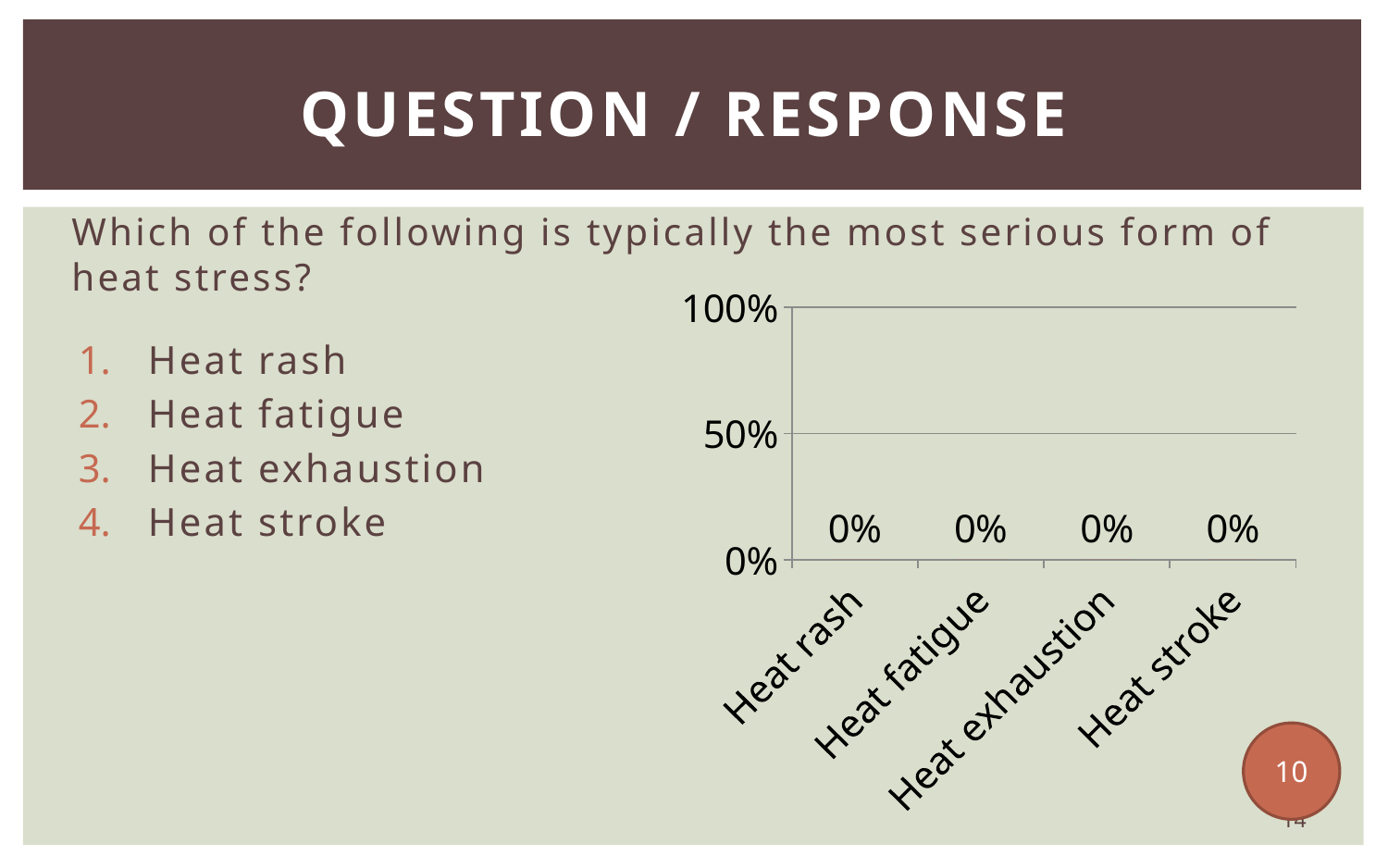
What kind of chart is shown on the slide? bar chart What is the label of the last category on the x axis of the chart? Heat stroke Is the value for Heat exhaustion greater or less than 50%? less What is the highest value labelled on the chart's y axis? 100% What is the value shown for Heat stroke in the chart? 0% What is the value shown for Heat exhaustion in the chart? 0% What is the value shown for Heat rash in the chart? 0% How many categories are shown on the x axis of the chart? 4 What is the value shown for Heat fatigue in the chart? 0% What is the difference between the values for Heat stroke and Heat rash? 0% Do the values rise, fall, or stay flat across the categories from Heat rash to Heat stroke? stay flat